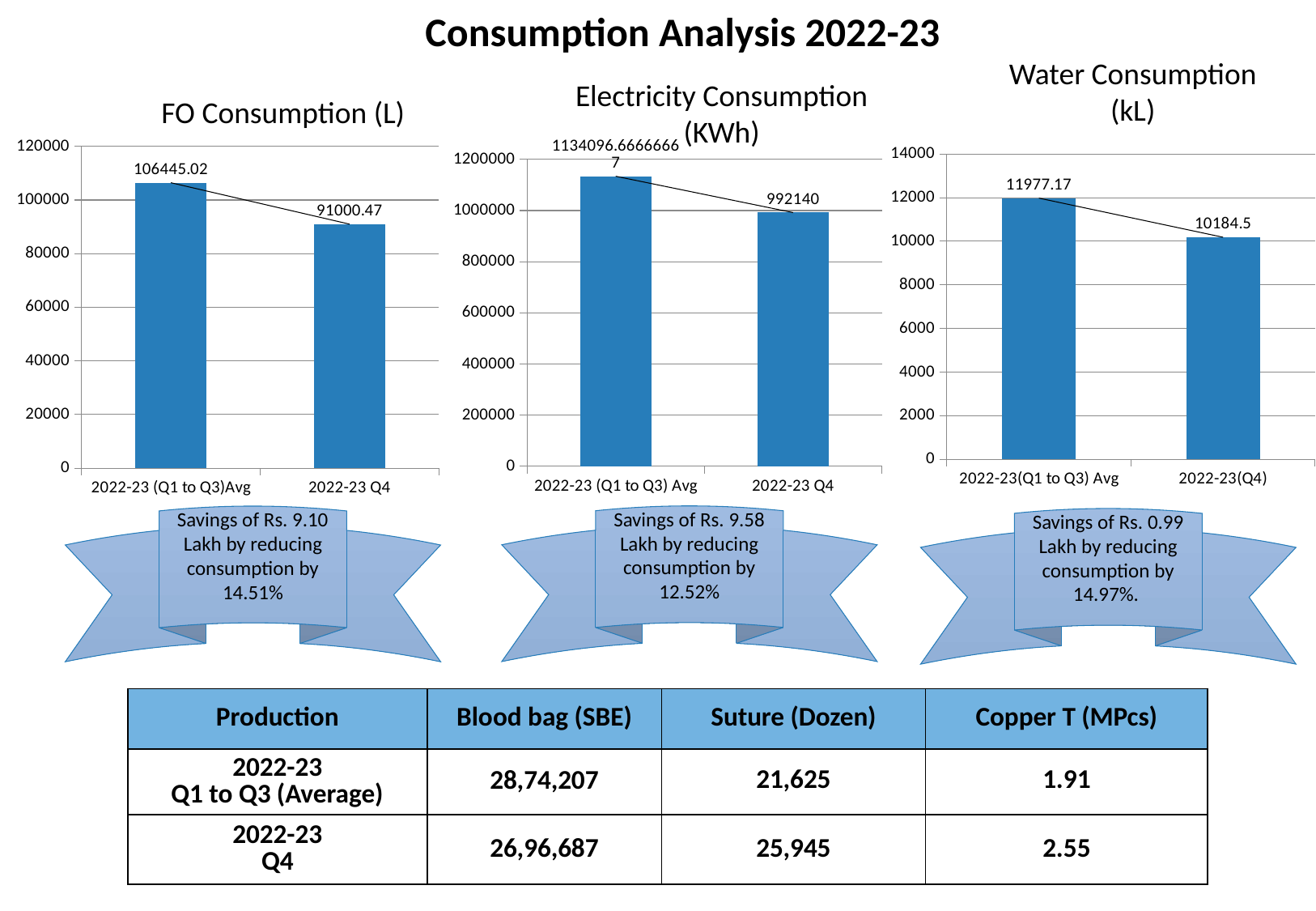
In the FO Consumption (L) chart, what is the value for 2022-23 (Q1 to Q3) Avg? 106445.02 In the Water Consumption (kL) chart, what is the difference between the 2022-23(Q1 to Q3) Avg value and the 2022-23(Q4) value? 1792.67 In the FO Consumption (L) chart, what is the difference between the 2022-23 (Q1 to Q3) Avg value and the 2022-23 Q4 value? 15444.55 What kind of chart is the FO Consumption (L) chart? bar chart In the Water Consumption (kL) chart, what is the value for 2022-23(Q4)? 10184.5 In the Electricity Consumption (KWh) chart, which category has the higher value? 2022-23 (Q1 to Q3) Avg In the Water Consumption (kL) chart, which category has the lowest value? 2022-23(Q4) In the Electricity Consumption (KWh) chart, is the value for 2022-23 Q4 greater or less than 1000000? less In the Electricity Consumption (KWh) chart, what is the value for 2022-23 Q4? 992140 How many categories are shown on the x axis of the Electricity Consumption (KWh) chart? 2 In the Water Consumption (kL) chart, what is the value for 2022-23(Q1 to Q3) Avg? 11977.17 In the FO Consumption (L) chart, what is the value for 2022-23 Q4? 91000.47